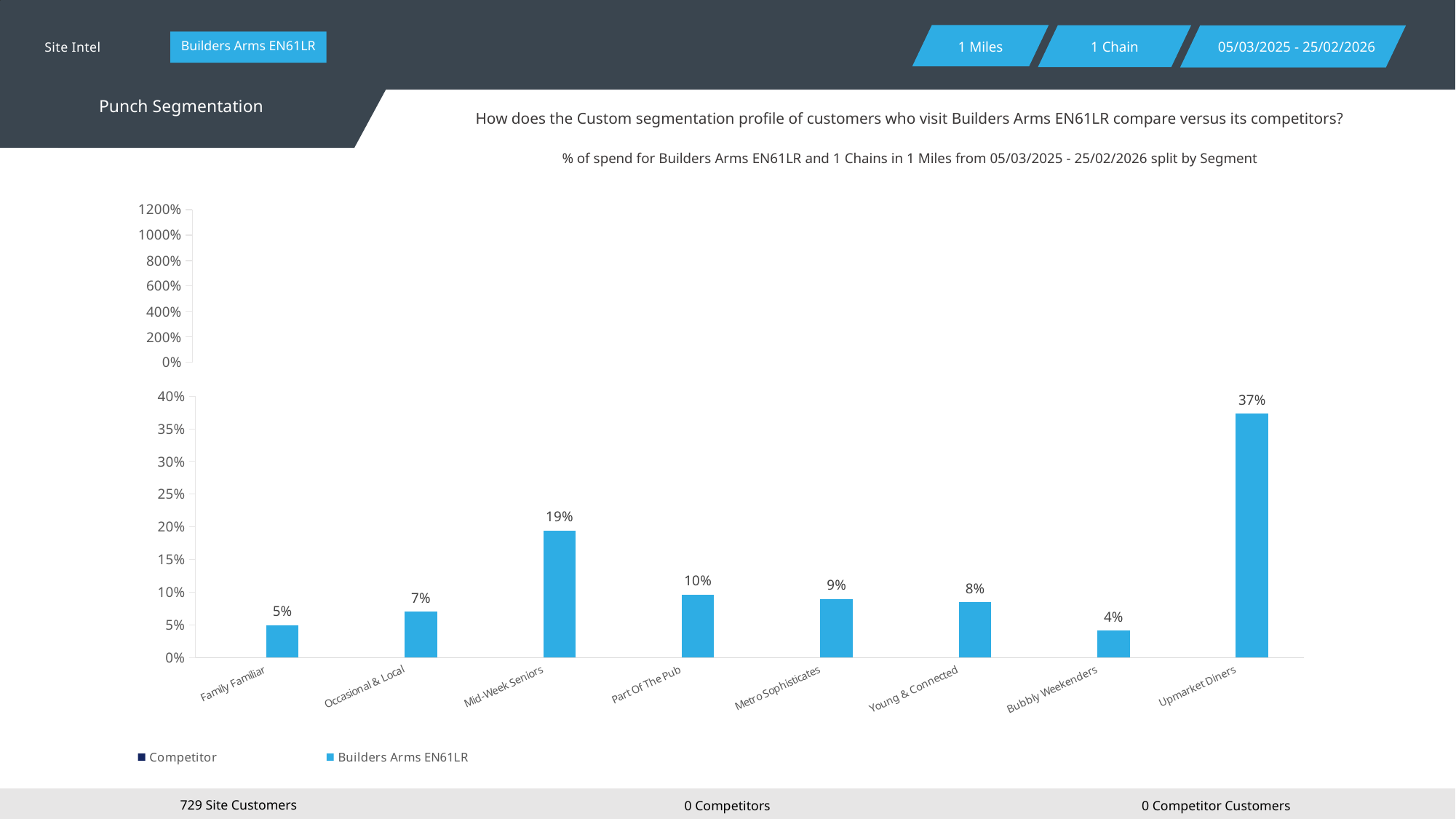
Which segment has the lowest % of spend? Bubbly Weekenders How many segments are shown on the x axis of the bar chart? 8 What is the difference between the values for Upmarket Diners and Mid-Week Seniors? 18% How many series does the legend list? 2 Which series is shown in light blue in the legend? Builders Arms EN61LR What is the value for Upmarket Diners? 37% What is the value for Mid-Week Seniors? 19% What is the value for Bubbly Weekenders? 4% Which segment has the highest % of spend? Upmarket Diners Is the value for Mid-Week Seniors greater or less than 15%? greater What kind of chart is used to show the % of spend by segment? Bar chart Which is larger, the value for Part Of The Pub or the value for Occasional & Local? Part Of The Pub